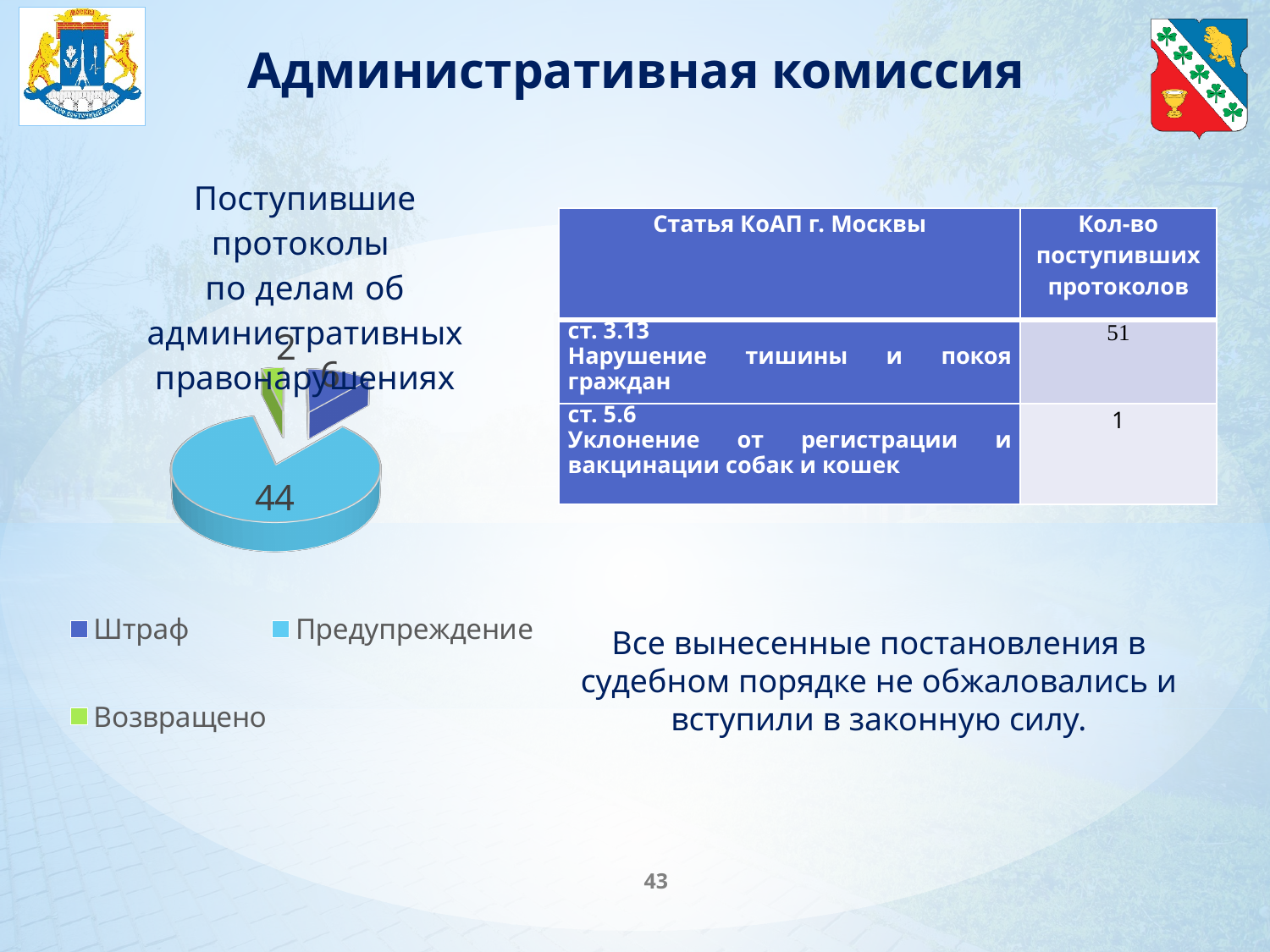
Which legend entry is shown in dark blue in the pie chart? Штраф Which category has the largest slice in the pie chart? Предупреждение What is the value for Предупреждение in the pie chart? 44 What colour represents Возвращено in the pie chart? Green What is the title of the pie chart? Поступившие протоколы по делам об административных правонарушениях What kind of chart is shown on the slide? Pie chart Which is larger in the pie chart, Предупреждение or Штраф? Предупреждение Which is larger in the pie chart, Предупреждение or Возвращено? Предупреждение How many categories does the legend of the pie chart list? 3 Which category has the smallest slice in the pie chart? Возвращено